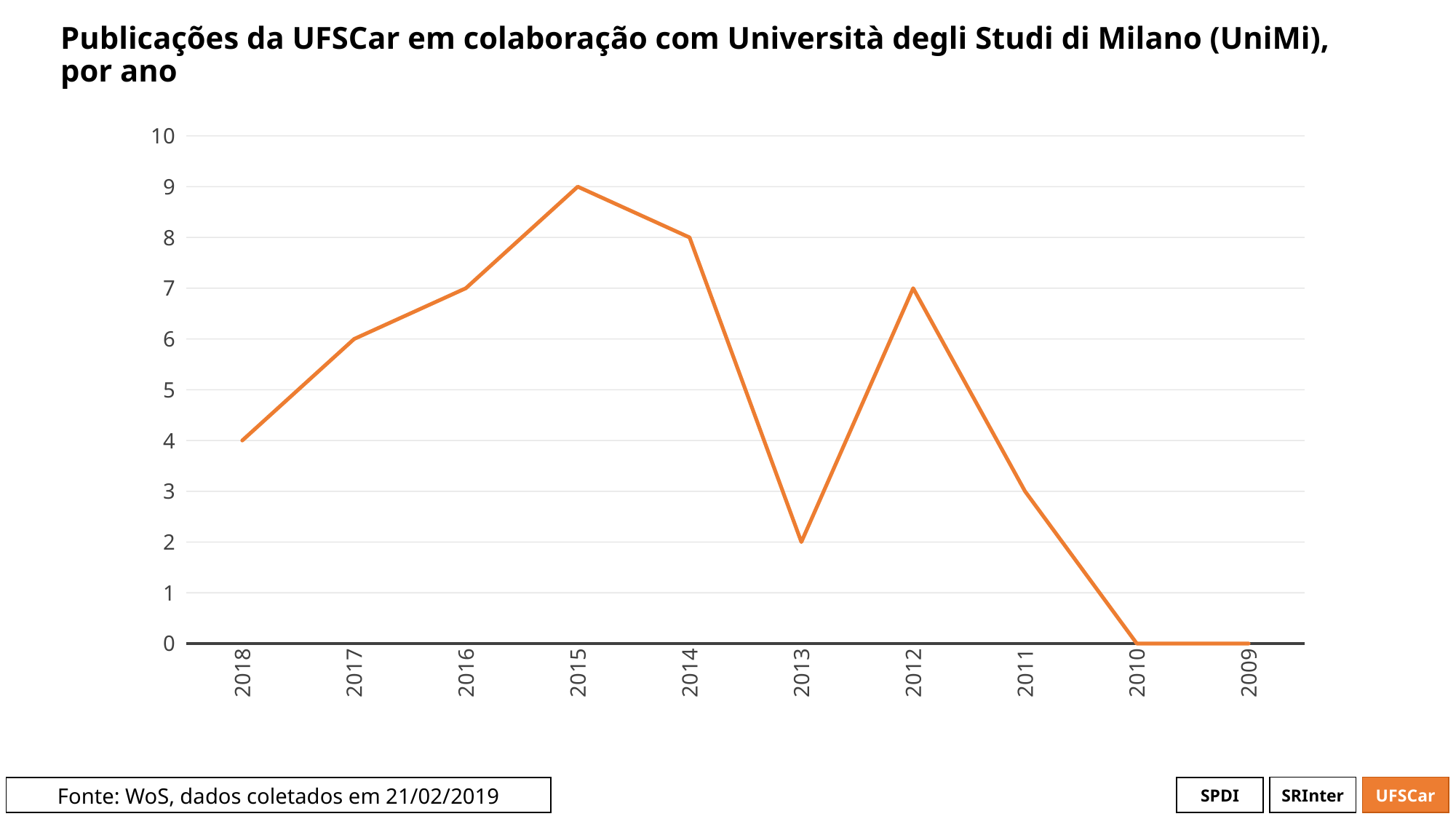
What is the source cited at the bottom of the slide? WoS, dados coletados em 21/02/2019 What is the difference between the values for 2015 and 2013? 7 Does the line rise or fall from 2018 to 2015 along the x axis? Rises What type of chart is shown on the slide? Line chart What is the value for 2010? 0 What is the value for 2013? 2 What is the value for 2015? 9 Which year has the highest value? 2015 Is the value for 2017 greater or less than 5? greater Which is larger, the value for 2014 or the value for 2012? 2014 How many years are plotted on the x axis? 10 What is the value for 2018? 4